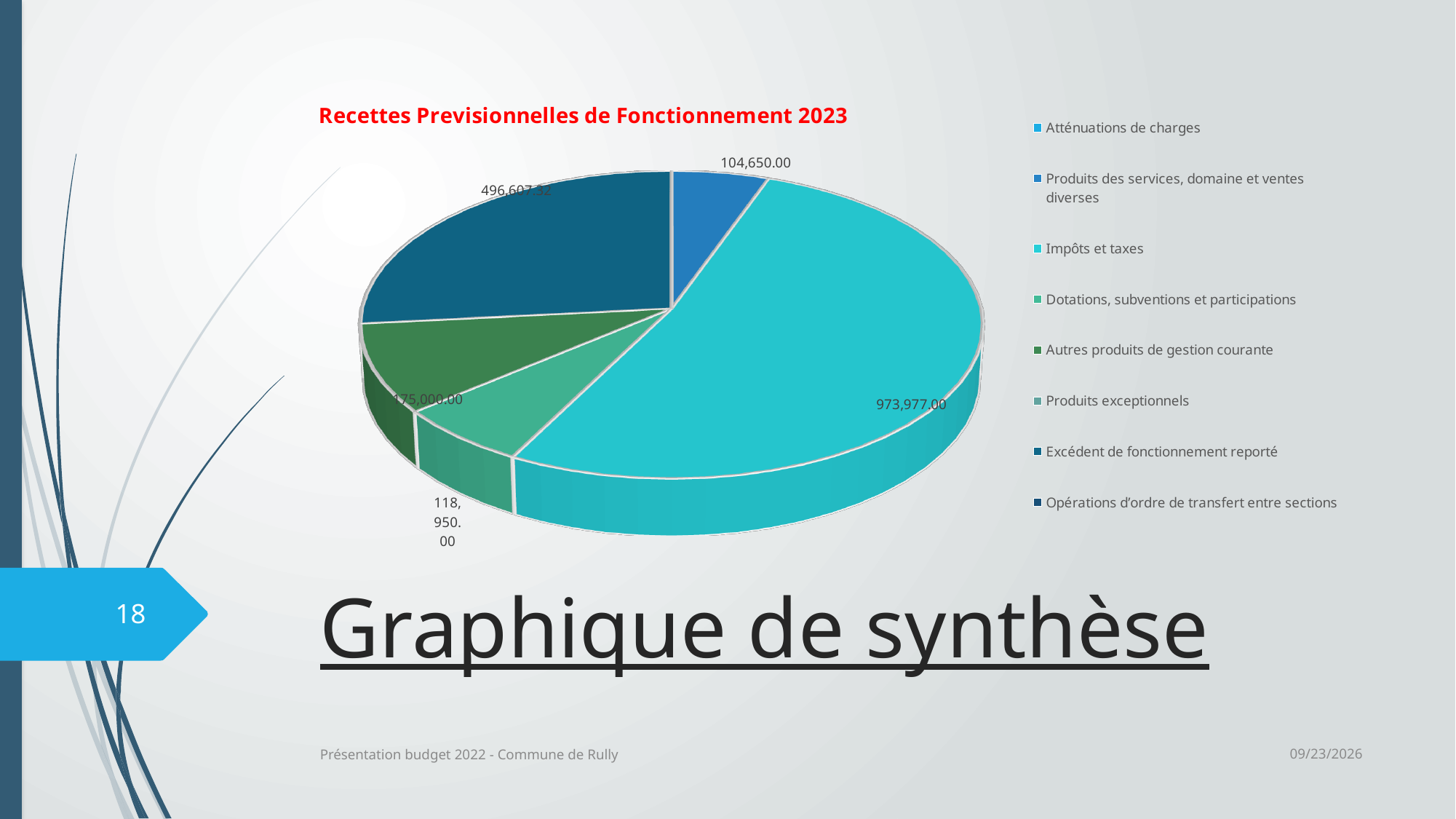
What is the difference between the values for Impôts et taxes and Produits des services, domaine et ventes diverses? 869,327.00 What kind of chart is shown on the slide? Pie chart What is the value shown for Dotations, subventions et participations? 118,950.00 What is the difference between the values for Autres produits de gestion courante and Dotations, subventions et participations? 56,050.00 Which category has the largest slice of the pie? Impôts et taxes What is the value shown for Impôts et taxes? 973,977.00 How many entries does the chart's legend list? 8 What is the value shown for Produits des services, domaine et ventes diverses? 104,650.00 What is the title of the chart? Recettes Previsionnelles de Fonctionnement 2023 What is the value shown for Autres produits de gestion courante? 175,000.00 Which is larger, Autres produits de gestion courante or Dotations, subventions et participations? Autres produits de gestion courante How many slices are visible in the pie chart? 5